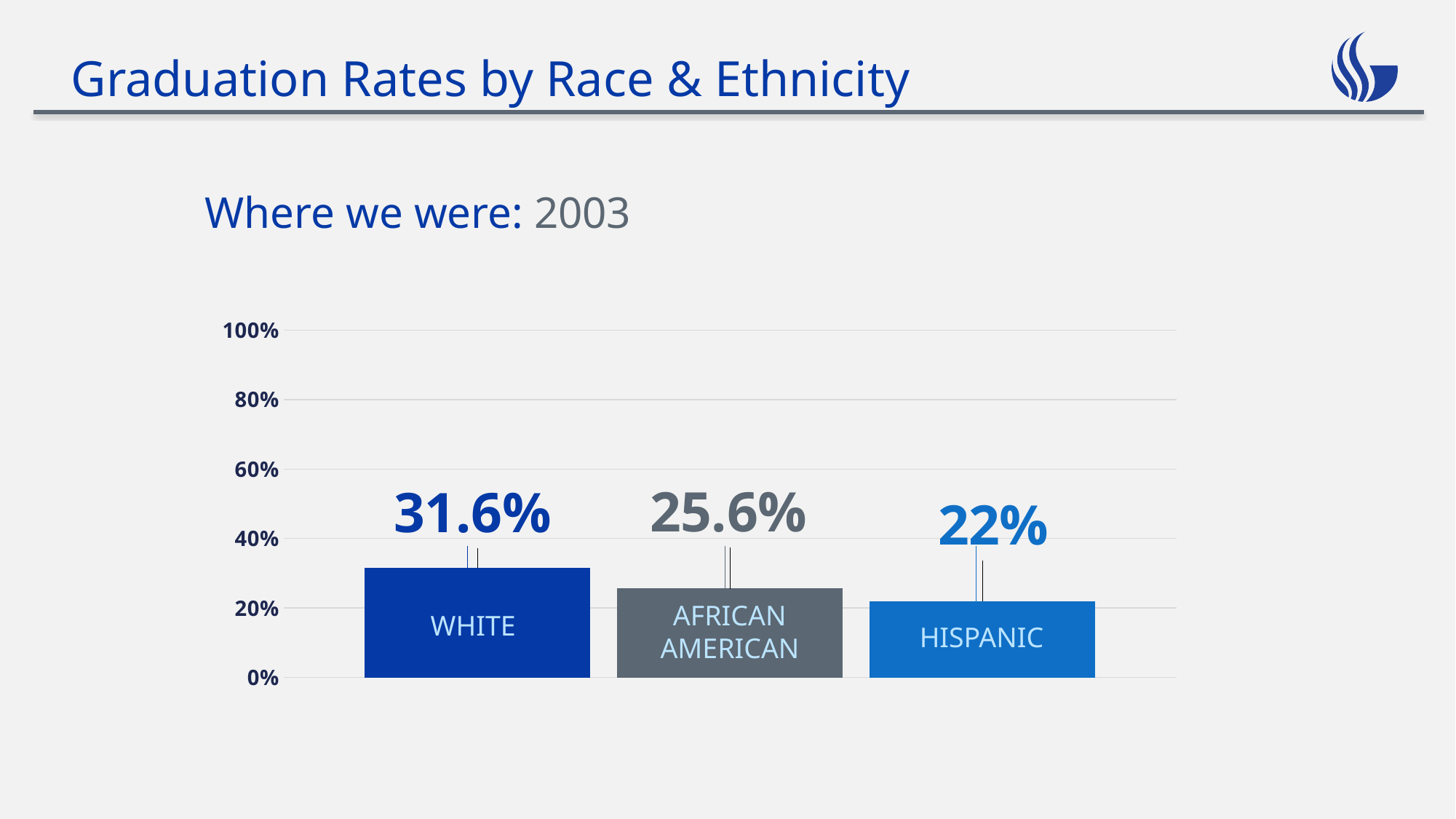
What is the difference between the White and Hispanic graduation rates? 9.6% What is the graduation rate for White students? 31.6% Which group has the highest graduation rate? White What kind of chart is shown on the slide? bar chart What year do the graduation rates on the slide refer to? 2003 What is the graduation rate for Hispanic students? 22% Which group has the lowest graduation rate? Hispanic Which is larger, the graduation rate for African American students or for Hispanic students? African American What is the graduation rate for African American students? 25.6% Is the graduation rate for White students greater or less than 40%? less What is the difference between the White and African American graduation rates? 6% How many groups are shown in the chart? 3